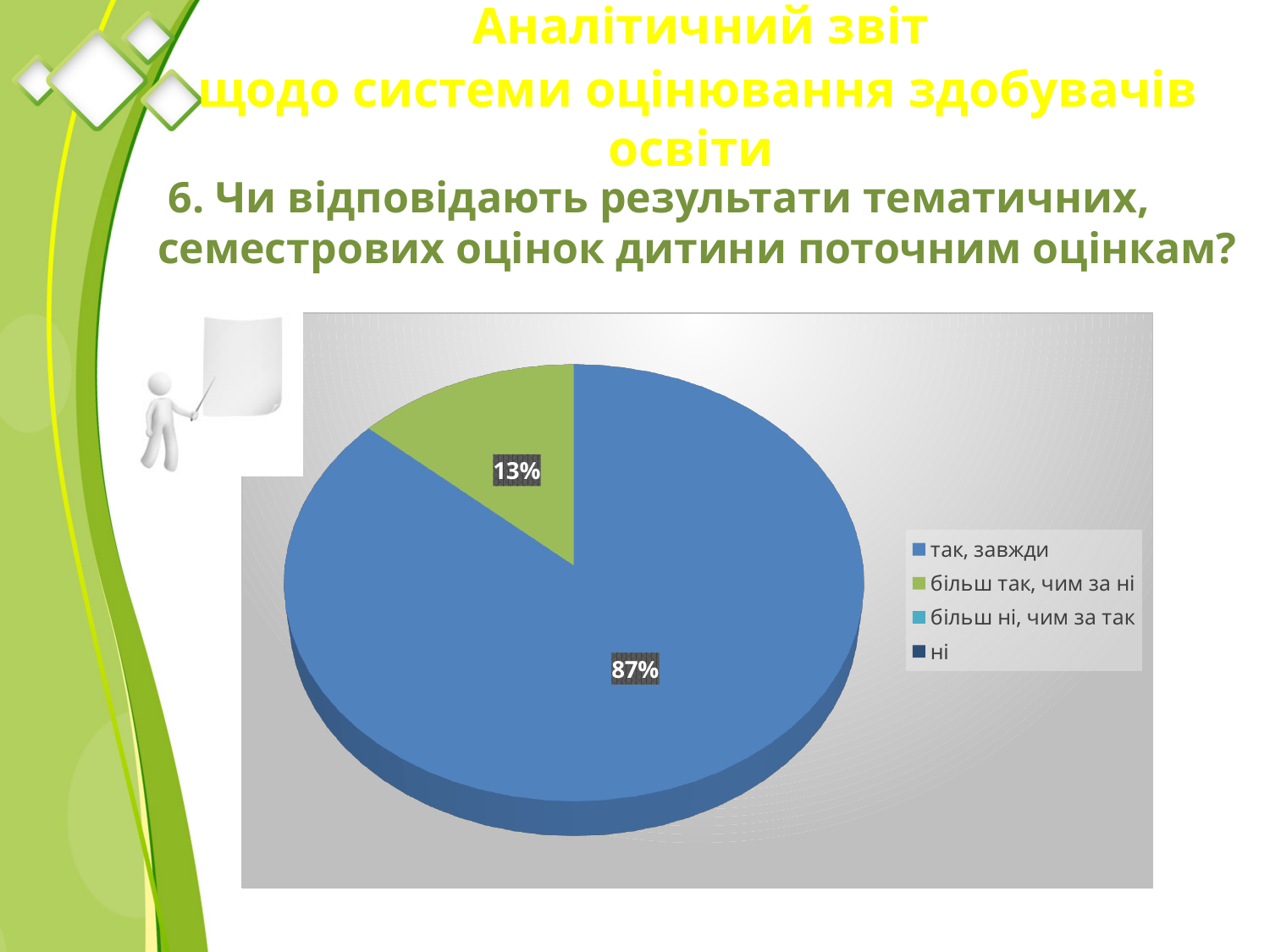
Is the share for "так, завжди" greater or less than 50%? greater What colour is the "більш так, чим за ні" slice? green What is the difference in percentage points between the "так, завжди" slice and the "більш так, чим за ні" slice? 74 How many entries does the legend list? 4 Which of the two labelled slices is larger: "так, завжди" or "більш так, чим за ні"? так, завжди What is the total of the two labelled slices, "так, завжди" and "більш так, чим за ні"? 100% What kind of chart is shown on the slide? pie chart What colour is the "так, завжди" slice? blue How many slices with data labels are visible in the pie? 2 Which category has the largest slice of the pie? так, завжди What share of the pie does the "більш так, чим за ні" slice represent? 13% What share of the pie does the "так, завжди" slice represent? 87%